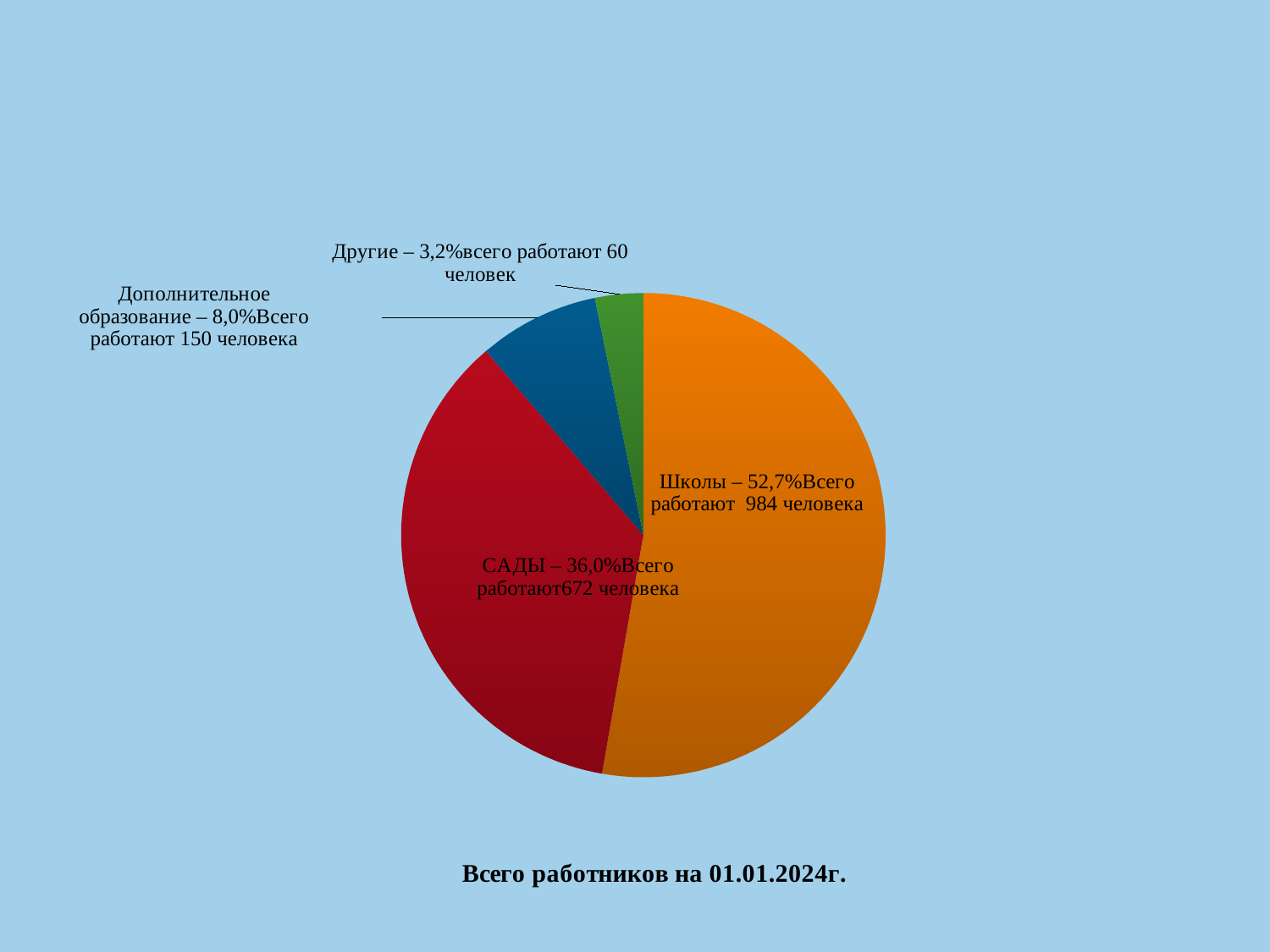
What share of the pie does the Школы slice represent? 52,7% How many slices does the pie chart have? 4 Which category has the largest slice of the pie? Школы Which is larger: the number of workers in Дополнительное образование or in Другие? Дополнительное образование What percentage is shown for Дополнительное образование? 8,0% What type of chart is shown on the slide? Pie chart What is the title text shown below the chart? Всего работников на 01.01.2024г. How many people work in САДЫ according to the chart? 672 How many people are listed under Другие? 60 Which category has the smallest slice of the pie? Другие What is the difference in percentage points between the Школы and САДЫ slices? 16,7 How many more people work in Школы than in САДЫ? 312